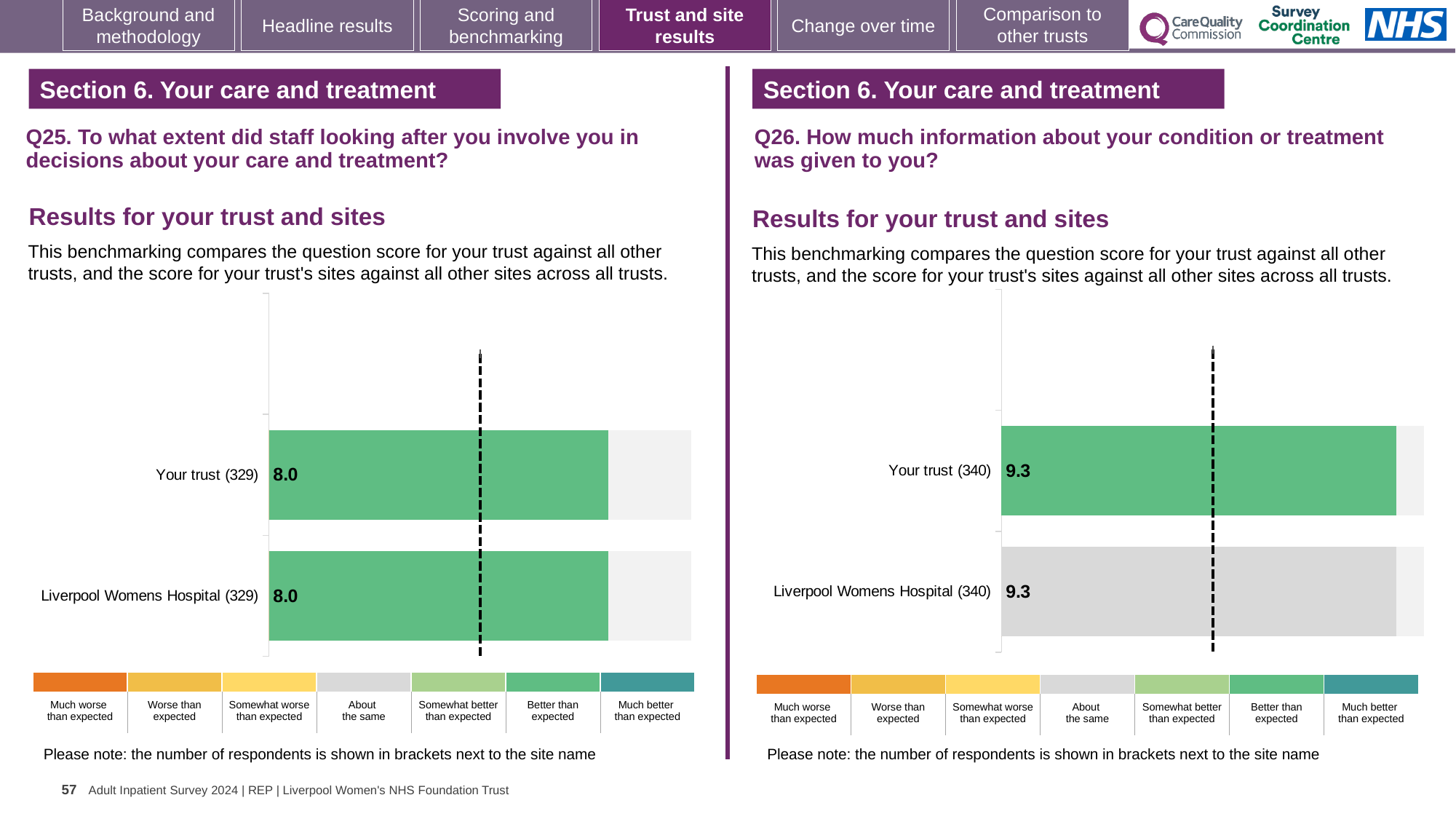
On the Q26 chart on the right, how many respondents are shown in brackets next to Liverpool Womens Hospital? 340 What kind of chart is shown on the left for Q25? Bar chart On the Q26 chart on the right, how many bars are plotted? 2 On the Q25 chart on the left, what is the score for Your trust? 8.0 Is the score for Your trust on the Q26 chart on the right larger than the score for Your trust on the Q25 chart on the left? Yes On the Q26 chart on the right, what is the score for Liverpool Womens Hospital? 9.3 On the Q25 chart on the left, which benchmark category does the colour of the Your trust bar correspond to? Better than expected On the Q25 chart on the left, how many respondents are shown in brackets next to Your trust? 329 On the Q25 chart on the left, what is the difference between the score for Your trust and the score for Liverpool Womens Hospital? 0.0 On the Q26 chart on the right, what is the score for Your trust? 9.3 On the Q25 chart on the left, what is the score for Liverpool Womens Hospital? 8.0 On the Q26 chart on the right, which benchmark category does the colour of the Liverpool Womens Hospital bar correspond to? About the same